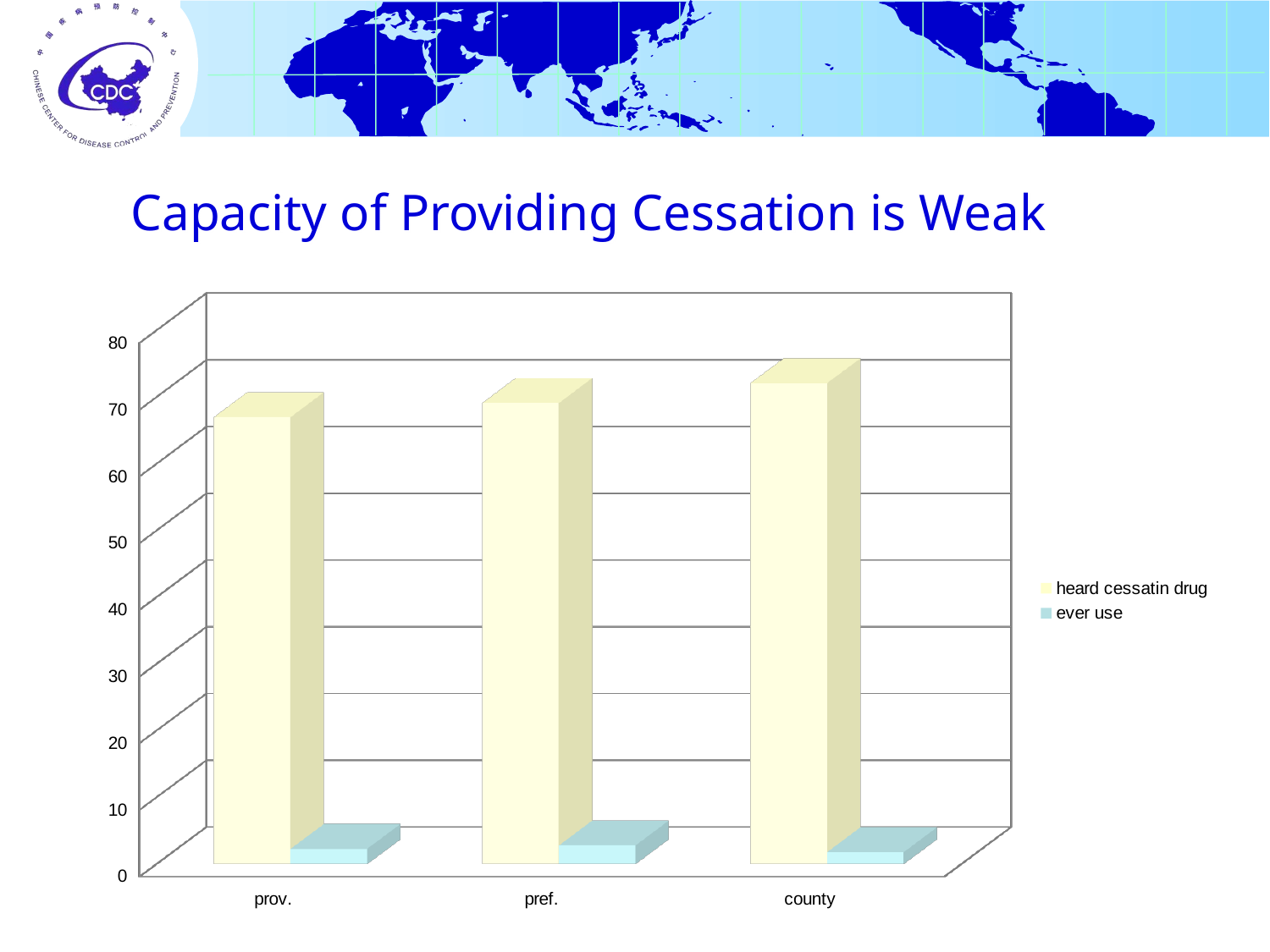
What is the title of the slide above the chart? Capacity of Providing Cessation is Weak Is the value for 'heard cessatin drug' for prov. greater or less than 60? greater Is the value for 'heard cessatin drug' for county greater or less than 80? less Is the value for 'ever use' for pref. greater or less than 10? less What kind of chart is shown on the slide? bar chart Which category has the lowest value for 'heard cessatin drug'? prov. For prov., which series has the larger value, 'heard cessatin drug' or 'ever use'? heard cessatin drug Which category has the highest value for 'heard cessatin drug'? county How many series does the chart's legend list? 2 Do the values for 'heard cessatin drug' rise or fall from prov. to county along the x axis? rise Which series is shown in light blue in the chart's legend? ever use How many categories are shown on the x axis of the chart? 3